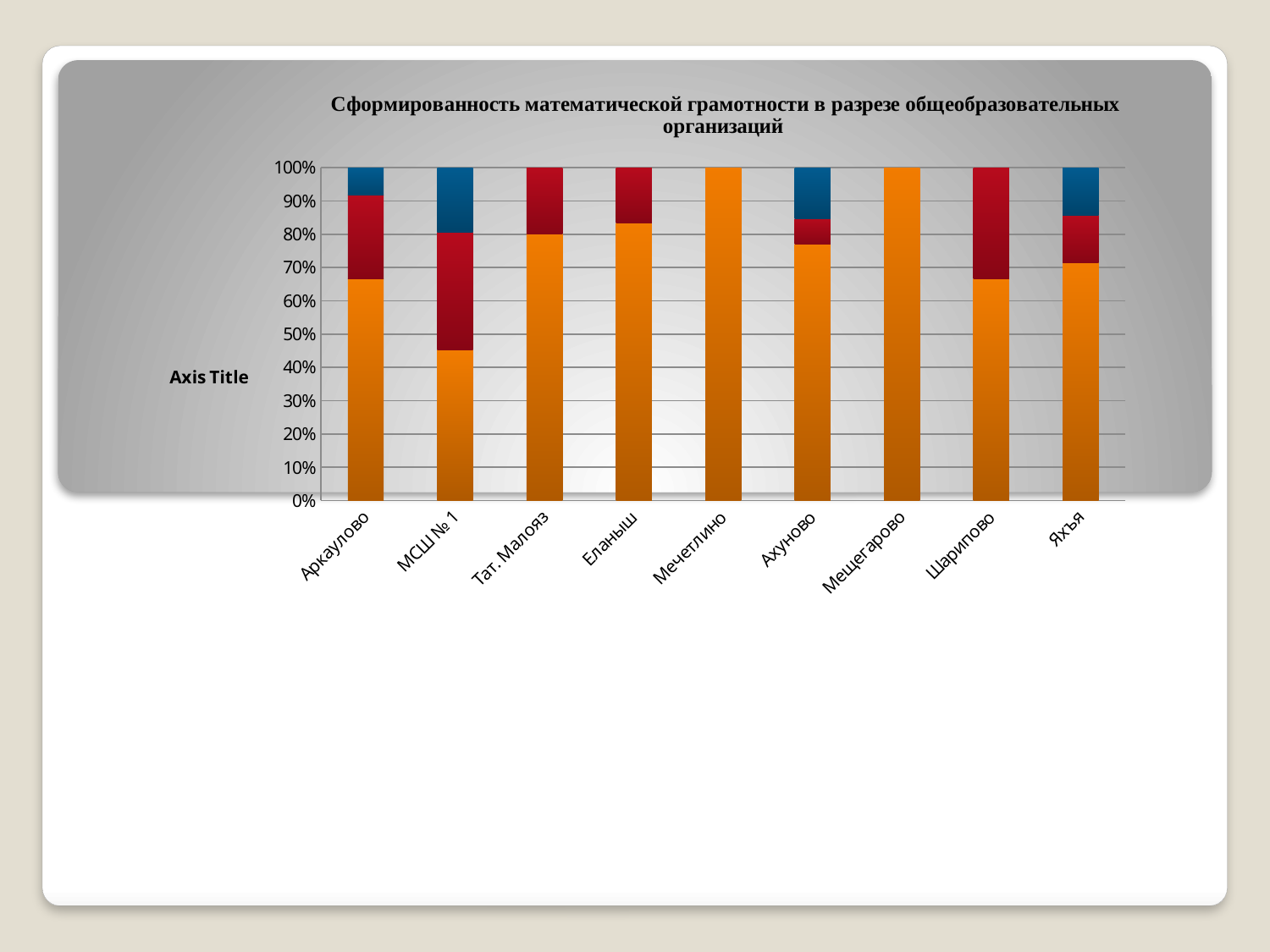
What kind of chart is shown on the slide? Stacked bar chart Which school has the largest blue (top) segment? МСШ № 1 Which school has the smallest orange (bottom) segment? МСШ № 1 Is the orange segment for МСШ № 1 greater or less than 50%? less Which school has the largest red (middle) segment? МСШ № 1 Is the orange segment for Шарипово greater or less than 70%? less What text is shown as the vertical axis title? Axis Title Is the orange segment for Аркаулово greater or less than 60%? greater Which is larger, the orange segment for Еланыш or the orange segment for МСШ № 1? Еланыш What is the title of the chart? Сформированность математической грамотности в разрезе общеобразовательных организаций How many schools (categories) are shown on the x axis? 9